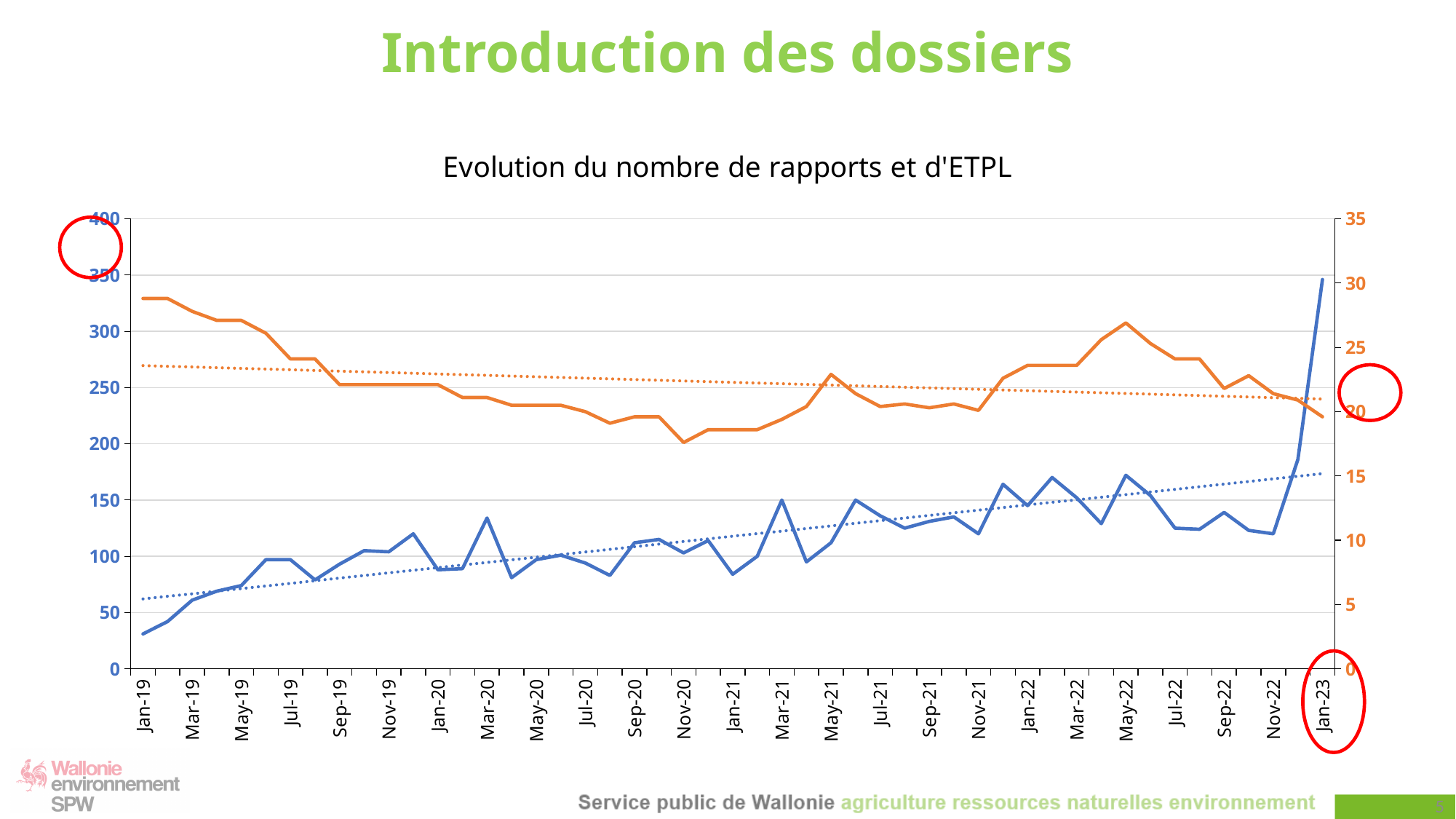
At which month does the blue line reach its highest value? Jan-23 At which month does the blue line have its lowest value? Jan-19 Is the value of the orange line at Nov-20 greater or less than 20 on the right axis? less What is the highest tick value shown on the right-hand axis? 35 Which is larger for the blue line: the value at Jan-19 or the value at Jan-23? Jan-23 Does the blue line generally rise or fall from Jan-19 to Jan-23? Rise What is the title of the chart? Evolution du nombre de rapports et d'ETPL What type of chart is shown on the slide? Line chart At which month does the orange line reach its lowest value? Nov-20 Is the value of the blue line at Jan-19 greater or less than 50 on the left axis? less Is the value of the blue line at Jan-23 greater or less than 300 on the left axis? greater